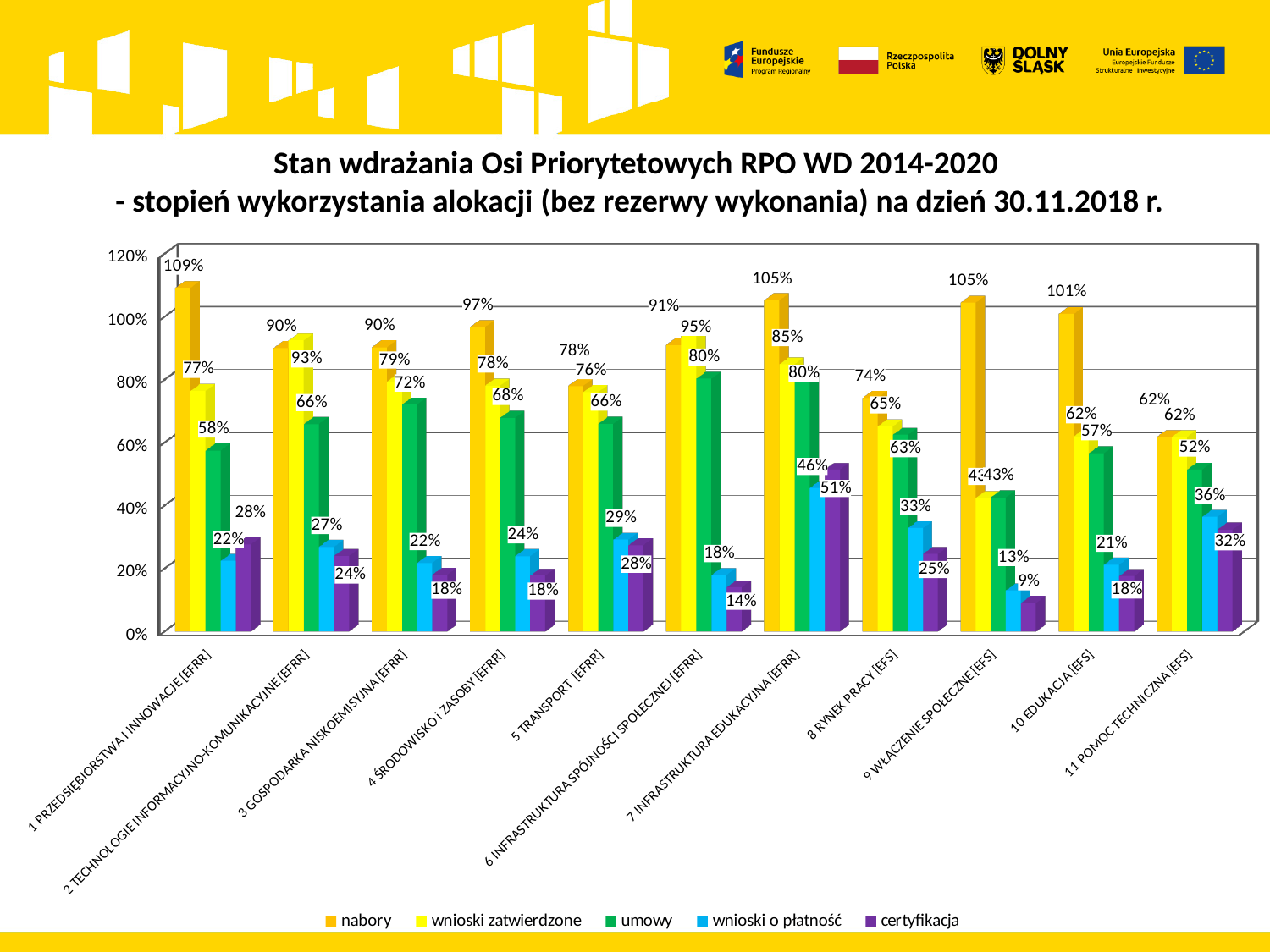
How many categories (priority axes) are shown on the x axis? 11 Which category has the highest 'wnioski o płatność' value? 7 INFRASTRUKTURA EDUKACYJNA [EFRR] What is the value of the 'nabory' series for '1 PRZEDSIĘBIORSTWA I INNOWACJE [EFRR]'? 109% What type of chart is shown on the slide? Bar chart What is the 'wnioski o płatność' value for '11 POMOC TECHNICZNA [EFS]'? 36% How many series does the legend list? 5 Which has a higher 'wnioski zatwierdzone' value: '2 TECHNOLOGIE INFORMACYJNO-KOMUNIKACYJNE [EFRR]' or '6 INFRASTRUKTURA SPÓJNOŚCI SPOŁECZNEJ [EFRR]'? 6 INFRASTRUKTURA SPÓJNOŚCI SPOŁECZNEJ [EFRR] Which category has the highest 'nabory' value? 1 PRZEDSIĘBIORSTWA I INNOWACJE [EFRR] What is the 'certyfikacja' value for '7 INFRASTRUKTURA EDUKACYJNA [EFRR]'? 51% For '5 TRANSPORT [EFRR]', what is the difference between the 'nabory' value and the 'umowy' value? 12 percentage points What is the 'umowy' value for '8 RYNEK PRACY [EFS]'? 63% Which category has the lowest 'certyfikacja' value? 9 WŁĄCZENIE SPOŁECZNE [EFS]